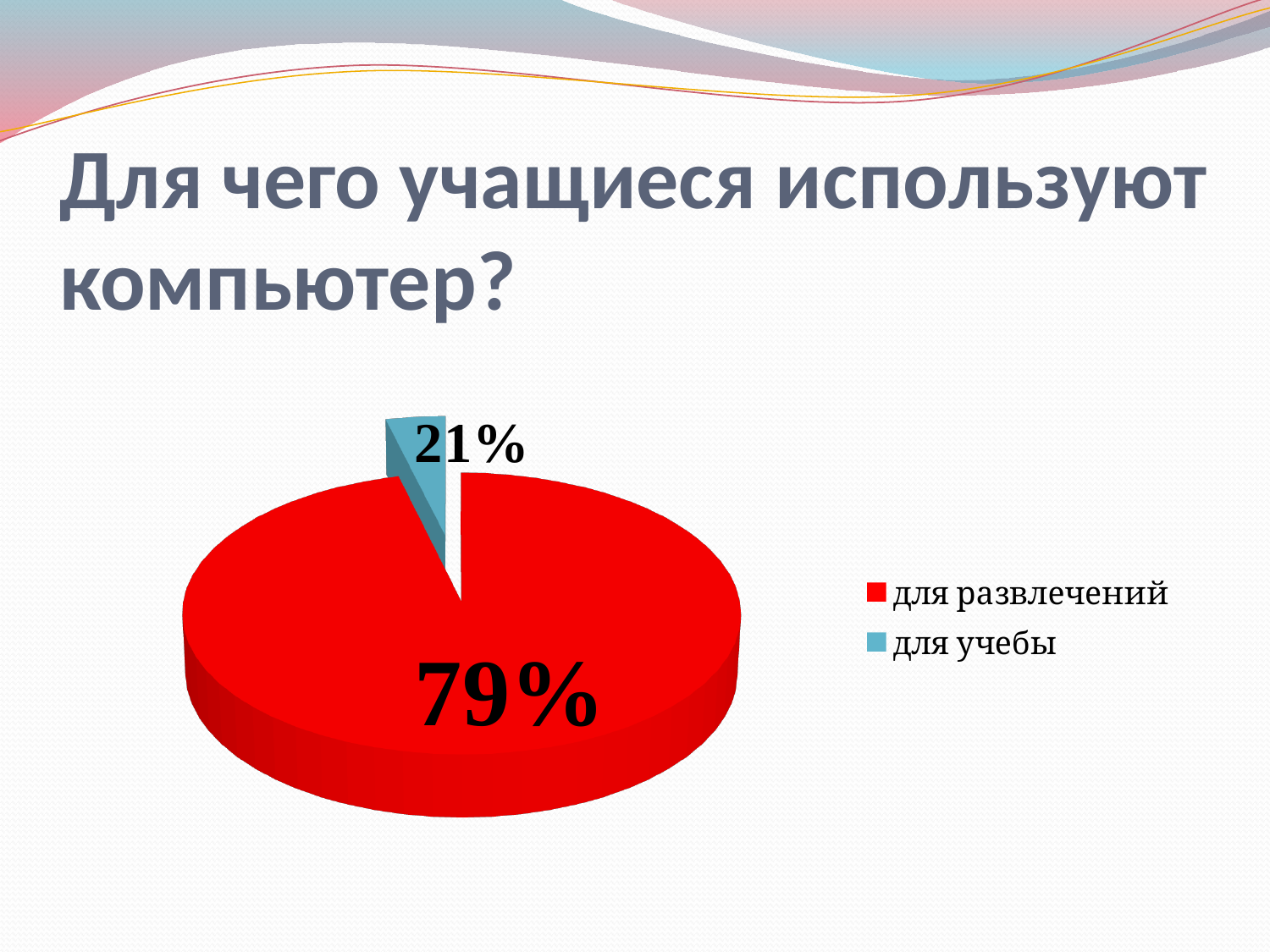
What is the title of the slide containing the chart? Для чего учащиеся используют компьютер? How many categories does the pie chart show? 2 Is the share for "для развлечений" greater or less than 50%? greater Is the share for "для учебы" greater or less than 50%? less What colour is the "для учебы" slice in the pie chart? blue What share of the pie is labelled "для развлечений"? 79% What kind of chart is shown on the slide? pie chart What is the difference in percentage points between the "для развлечений" and "для учебы" slices? 58 Which category has the largest slice of the pie? для развлечений Which slice is larger, "для развлечений" or "для учебы"? для развлечений What share of the pie is labelled "для учебы"? 21% Which category has the smallest slice of the pie? для учебы